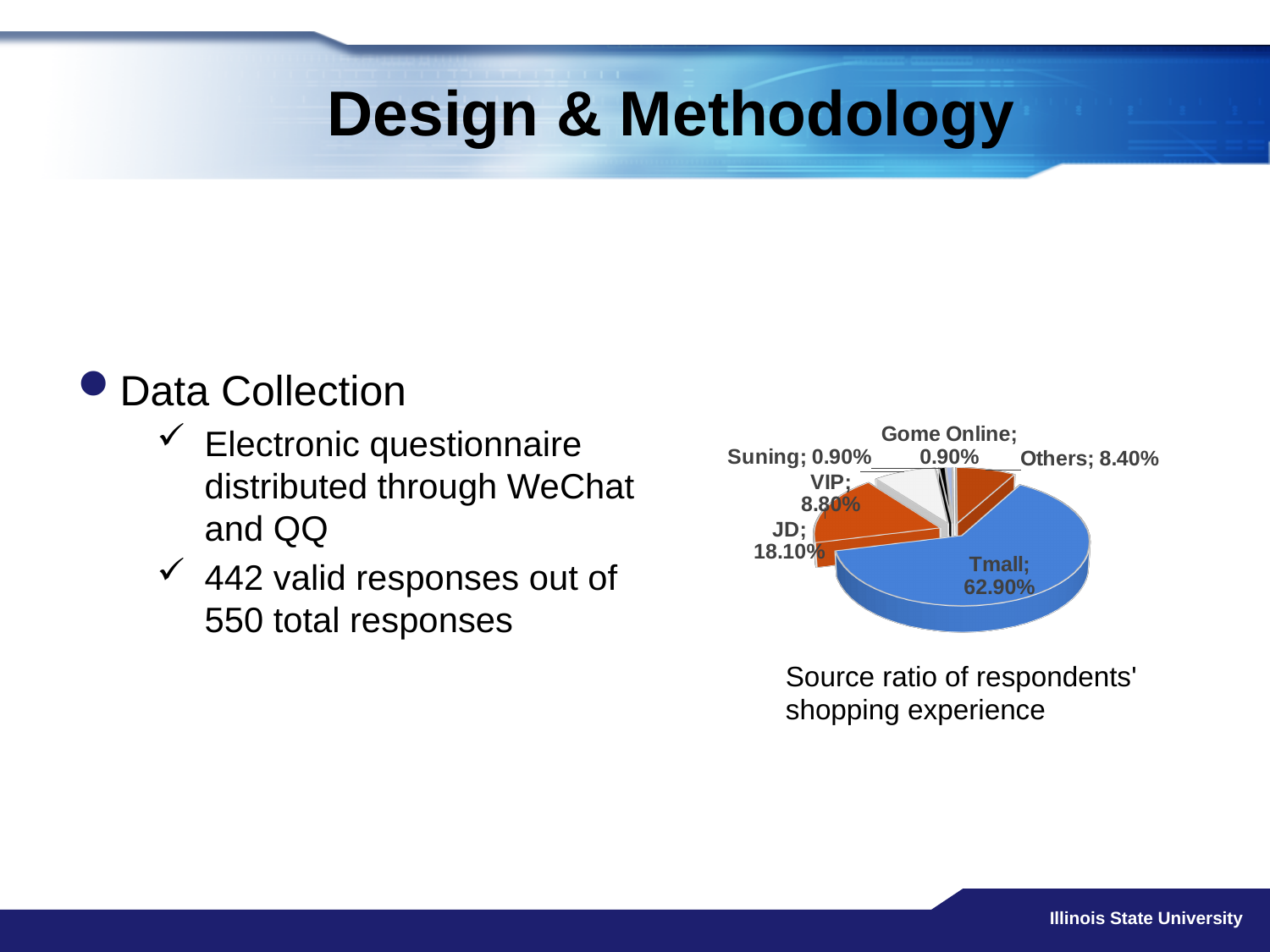
What is the caption below the pie chart? Source ratio of respondents' shopping experience What percentage is labelled for VIP? 8.80% What is the value shown for JD in the pie chart? 18.10% Which is larger, the share for JD or the share for VIP? JD Which category has the largest slice of the pie? Tmall What type of chart is shown on the slide? Pie chart What is the difference between the Tmall and JD percentages? 44.80% How many categories are shown in the pie chart? 6 What percentage is shown for Suning? 0.90% What is the value for Others in the pie chart? 8.40% Which is larger, the share for VIP or the share for Others? VIP What share of the pie does Tmall account for? 62.90%